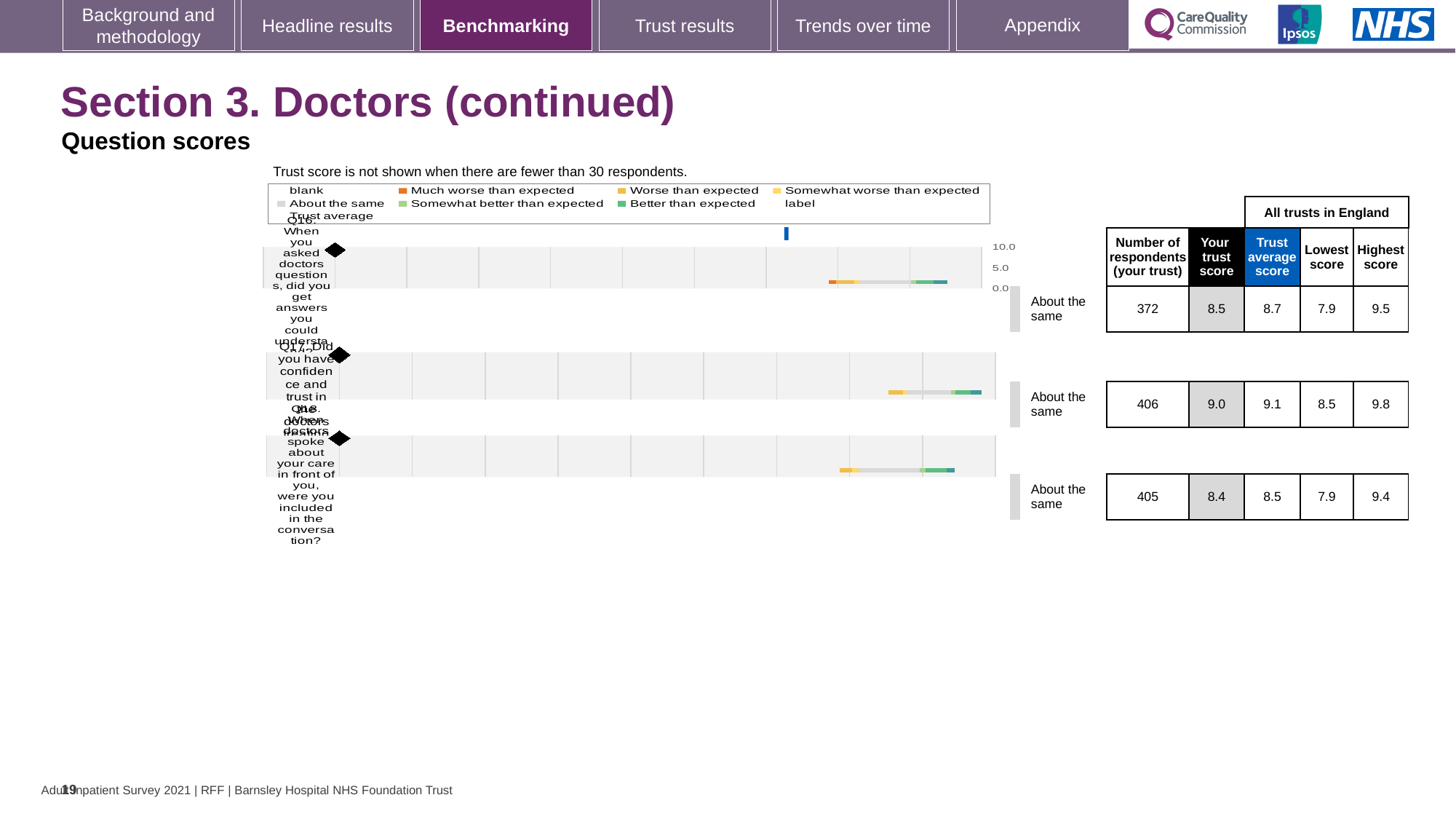
What is the difference between the trust average score and your trust score for Q16? 0.2 What kind of chart is used to show the question scores? Bar chart Is your trust score for Q17 greater or less than 5.0 on the chart axis? greater What is the 'Your trust score' value for Q16 (When you asked doctors questions, did you get answers you could understand)? 8.5 What benchmark category is shown for Q18 on the chart? About the same What is the lowest score across all trusts in England for Q17? 8.5 What is the highest score across all trusts in England for Q18 (When doctors spoke about your care in front of you, were you included in the conversation)? 9.4 How many questions are plotted on the chart? 3 How many respondents from your trust answered Q17 (Did you have confidence and trust in the doctors treating you)? 406 For Q17, which is larger: your trust score or the trust average score? Trust average score Which of the three questions has the highest 'Your trust score'? Q17 Which of the three questions has the lowest 'Your trust score'? Q18